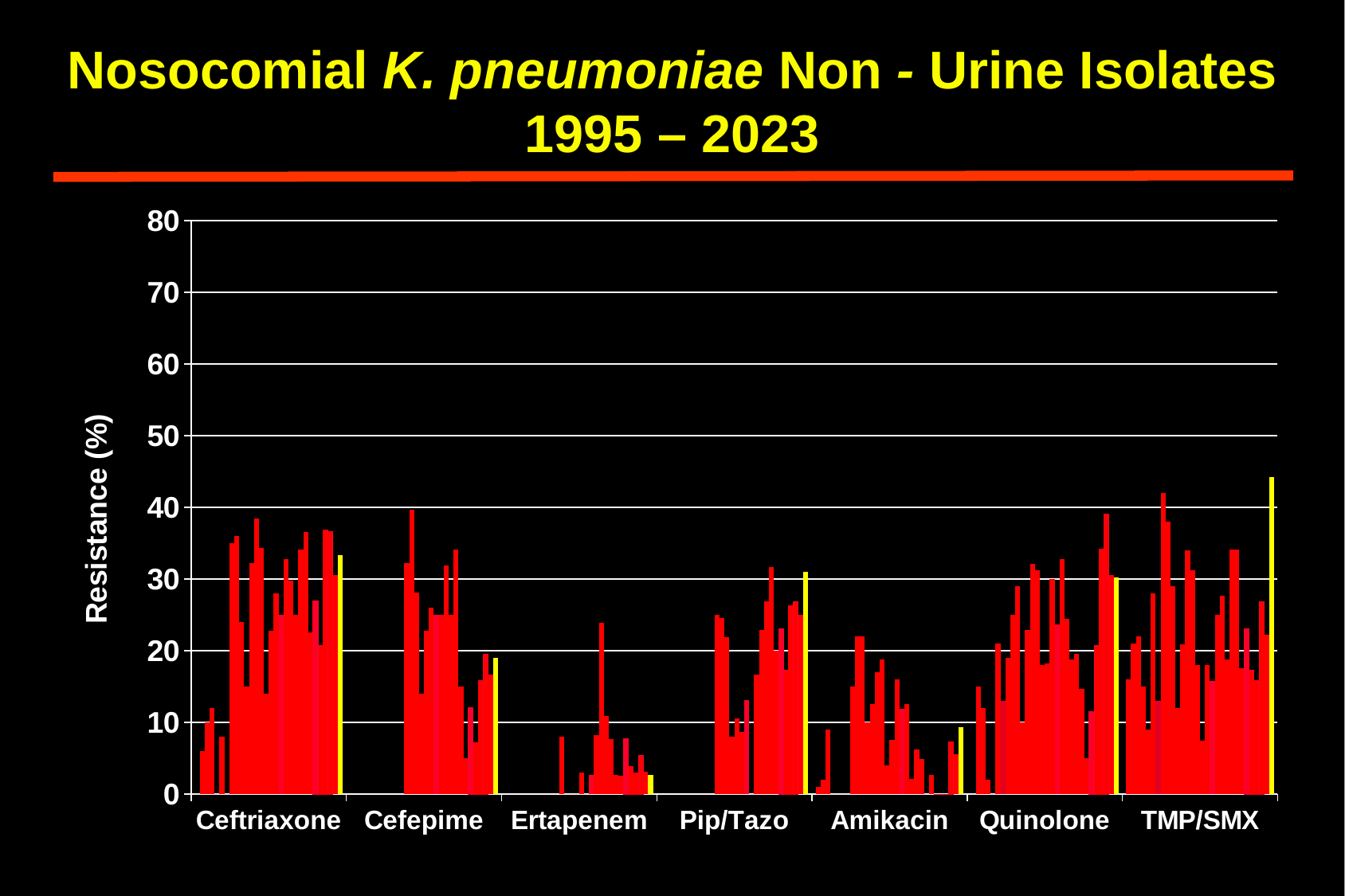
Which has the taller yellow (final) bar, Ceftriaxone or Ertapenem? Ceftriaxone What is the label of the y axis? Resistance (%) Is the yellow (final) bar for TMP/SMX greater or less than 40? greater Is the yellow (final) bar for Ertapenem greater or less than 10? less Which antibiotic category has the tallest yellow (final) bar? TMP/SMX Is the yellow (final) bar for Ceftriaxone greater or less than 30? greater Which antibiotic category has the shortest yellow (final) bar? Ertapenem What kind of chart is shown on the slide? bar chart What is the highest value shown on the y axis? 80 How many antibiotic categories are shown along the x axis? 7